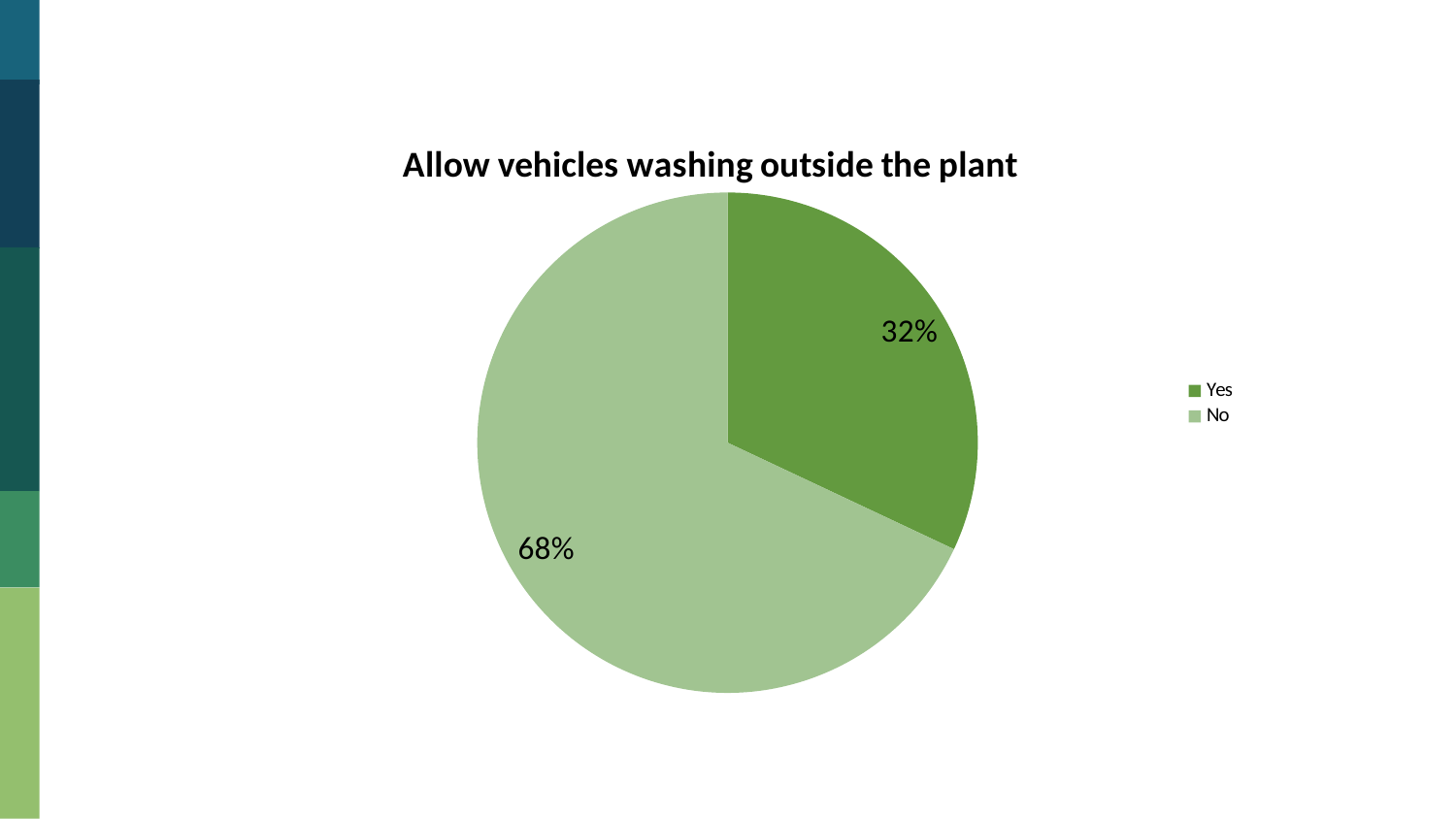
What kind of chart is shown on the slide? Pie chart What share of the pie does the Yes slice represent? 32% Which response has the smallest share of the pie? Yes What is the title of the chart? Allow vehicles washing outside the plant What percentage of respondents answered No to allowing vehicle washing outside the plant? 68% What is the difference in percentage points between the No and Yes shares? 36 What percentage of respondents answered Yes to allowing vehicle washing outside the plant? 32% How many slices does the pie chart have? 2 Which is larger, the share for Yes or the share for No? No Which response has the largest share of the pie? No How many entries does the legend list? 2 Which legend entry is shown in the darker green colour? Yes